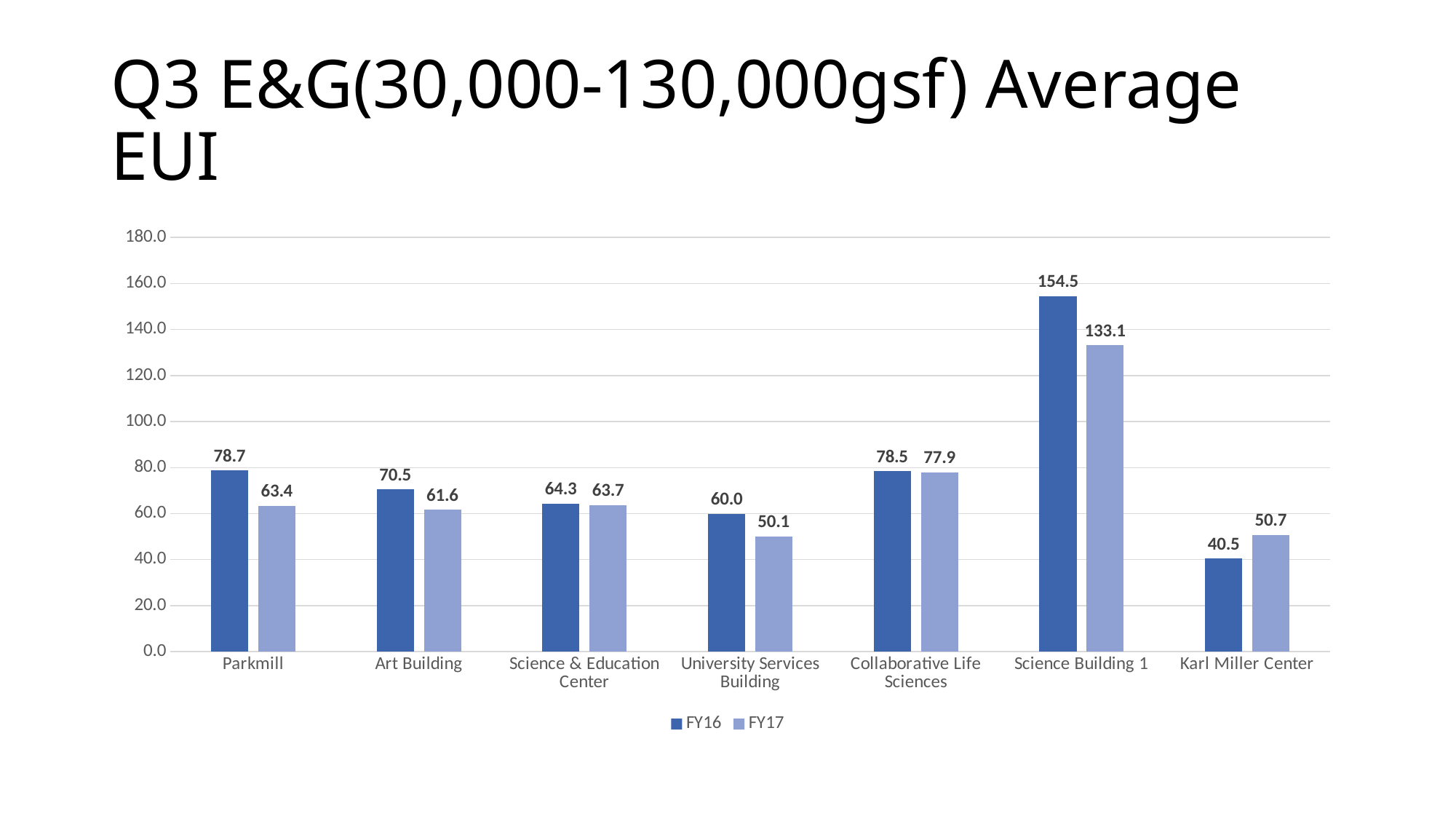
How many series does the legend list? 2 What is the FY16 value for Parkmill? 78.7 Which is larger for Karl Miller Center, the FY16 value or the FY17 value? FY17 What kind of chart is shown on the slide? Bar chart What is the FY17 value for Science Building 1? 133.1 Which building has the highest FY16 value? Science Building 1 What is the difference between the FY16 and FY17 values for Science Building 1? 21.4 How many buildings are shown on the x axis? 7 Which building has the lowest FY16 value? Karl Miller Center What is the title of the chart on the slide? Q3 E&G(30,000-130,000gsf) Average EUI Is the FY16 value for Science Building 1 greater or less than 140? greater What is the FY17 value for University Services Building? 50.1